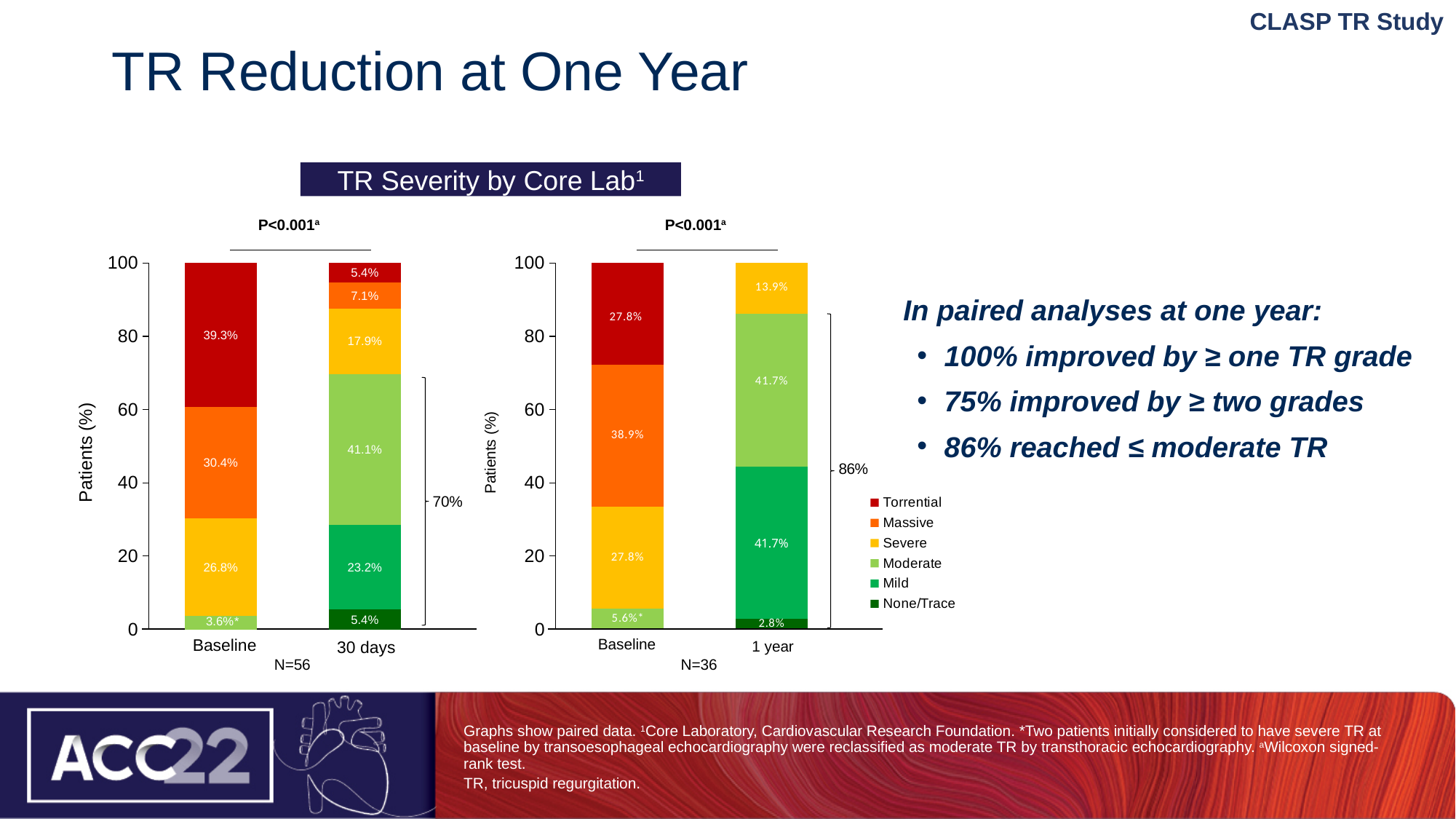
In the right chart (N=36), which is larger: the torrential share at baseline or the severe share at 1 year? Torrential share at baseline In the left chart (N=56), which TR severity category has the largest share of patients at baseline? Torrential In the right chart (N=36), what percentage of patients had none/trace TR at 1 year? 2.8% In the right chart (N=36), what percentage of patients reached moderate or better TR at 1 year, as annotated by the bracket? 86% What type of chart is used to show TR severity by core lab? Stacked bar chart In the right chart (N=36), what percentage of patients had massive TR at baseline? 38.9% In the left chart (N=56), which TR severity category has the largest share of patients at 30 days? Moderate In the left chart (N=56), what is the difference between the severe TR share at baseline and at 30 days? 8.9% In the left chart (N=56), what percentage of patients had torrential TR at baseline? 39.3% In the right chart (N=36), what percentage of patients had mild TR at 1 year? 41.7% How many TR severity categories does the legend list? 6 In the left chart (N=56), what percentage of patients had moderate TR at 30 days? 41.1%